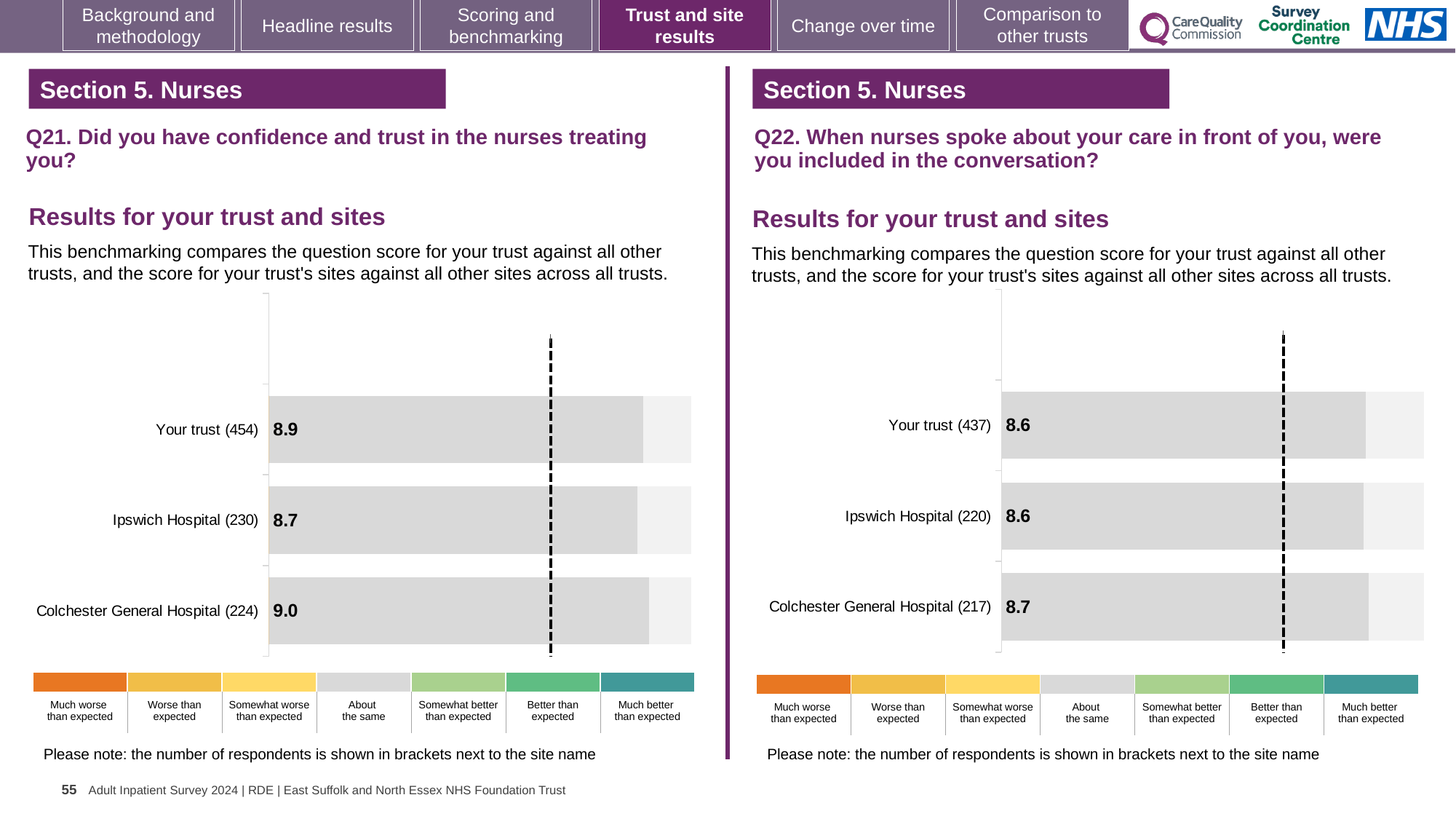
In the Q21 chart on the left, what is the difference between the scores for Colchester General Hospital (224) and Ipswich Hospital (230)? 0.3 What type of chart is used for the Q21 results on the left? Bar chart In the Q22 chart on the right, which site or trust has the highest score? Colchester General Hospital (217) In the Q21 chart on the left, what is the score for Your trust (454)? 8.9 In the Q21 chart on the left, which site or trust has the highest score? Colchester General Hospital (224) Which is larger: the Q21 score for Your trust (454) on the left chart or the Q22 score for Your trust (437) on the right chart? Q21 score for Your trust (454) In the Q22 chart on the right, what is the score for Colchester General Hospital (217)? 8.7 In the Q22 chart on the right, what is the score for Ipswich Hospital (220)? 8.6 In the Q21 chart on the left, what is the score for Colchester General Hospital (224)? 9.0 In the Q22 chart on the right, what is the difference between the scores for Colchester General Hospital (217) and Your trust (437)? 0.1 How many bars are plotted in the Q22 chart on the right? 3 In the Q21 chart on the left, which site or trust has the lowest score? Ipswich Hospital (230)